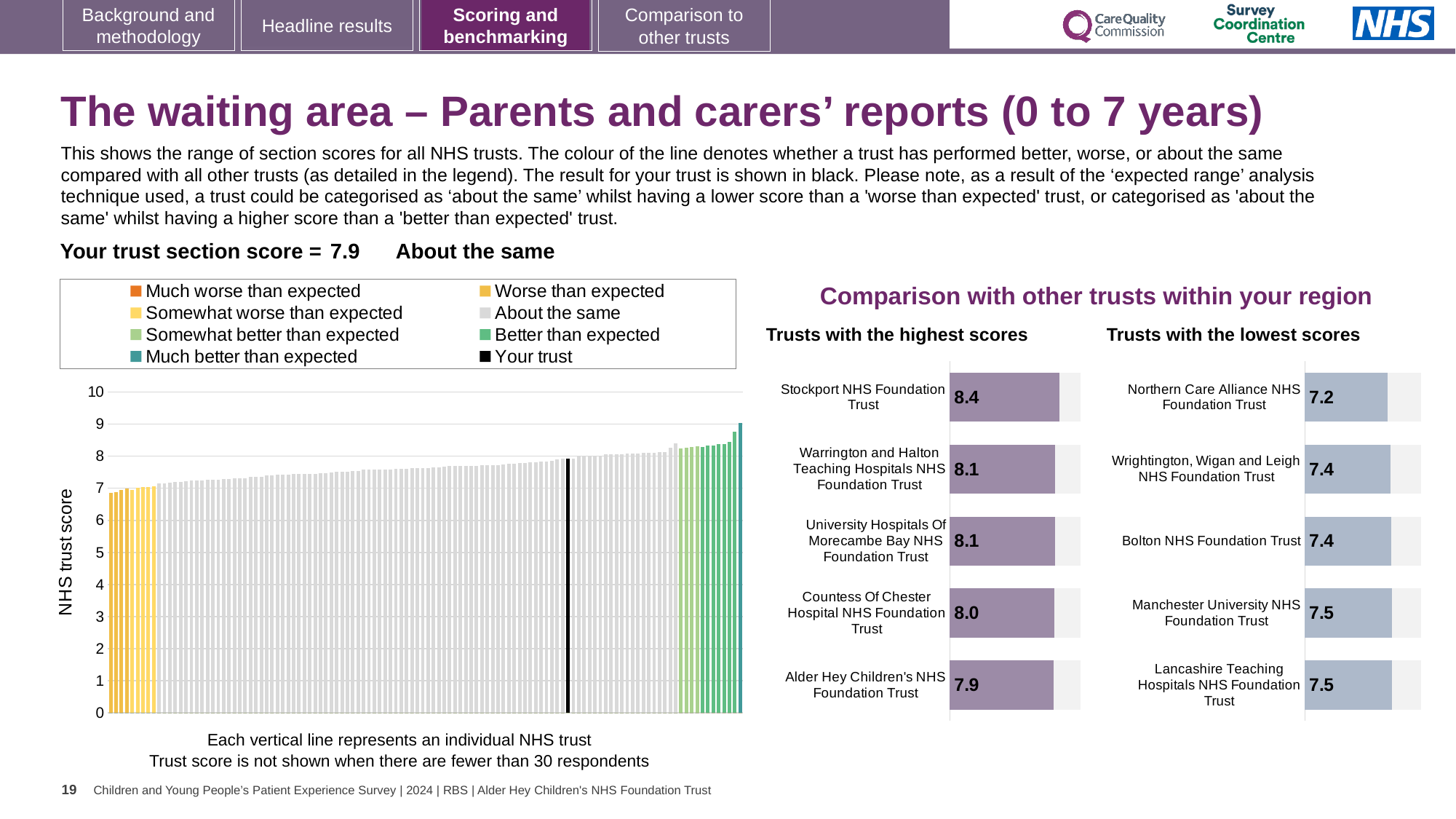
In the 'Trusts with the lowest scores' chart, which trust has the lowest score? Northern Care Alliance NHS Foundation Trust In the 'Trusts with the lowest scores' chart, how many trusts are shown? 5 In the large chart on the left showing all NHS trusts, do the scores rise or fall from left to right? Rise In the 'Trusts with the highest scores' chart, what is the score for Alder Hey Children's NHS Foundation Trust? 7.9 In the 'Trusts with the highest scores' chart, what is the difference between the scores of Stockport NHS Foundation Trust and Alder Hey Children's NHS Foundation Trust? 0.5 In the 'Trusts with the lowest scores' chart, what is the difference between the scores of Lancashire Teaching Hospitals NHS Foundation Trust and Northern Care Alliance NHS Foundation Trust? 0.3 In the 'Trusts with the highest scores' chart, which trust has the highest score? Stockport NHS Foundation Trust In the 'Trusts with the lowest scores' chart, what is the score for Bolton NHS Foundation Trust? 7.4 In the 'Trusts with the highest scores' chart, what is the score for Stockport NHS Foundation Trust? 8.4 In the 'Trusts with the lowest scores' chart, what is the score for Northern Care Alliance NHS Foundation Trust? 7.2 What kind of chart is the large chart on the left showing all NHS trusts? Bar chart In the 'Trusts with the highest scores' chart, which has the larger score: Stockport NHS Foundation Trust or Countess Of Chester Hospital NHS Foundation Trust? Stockport NHS Foundation Trust